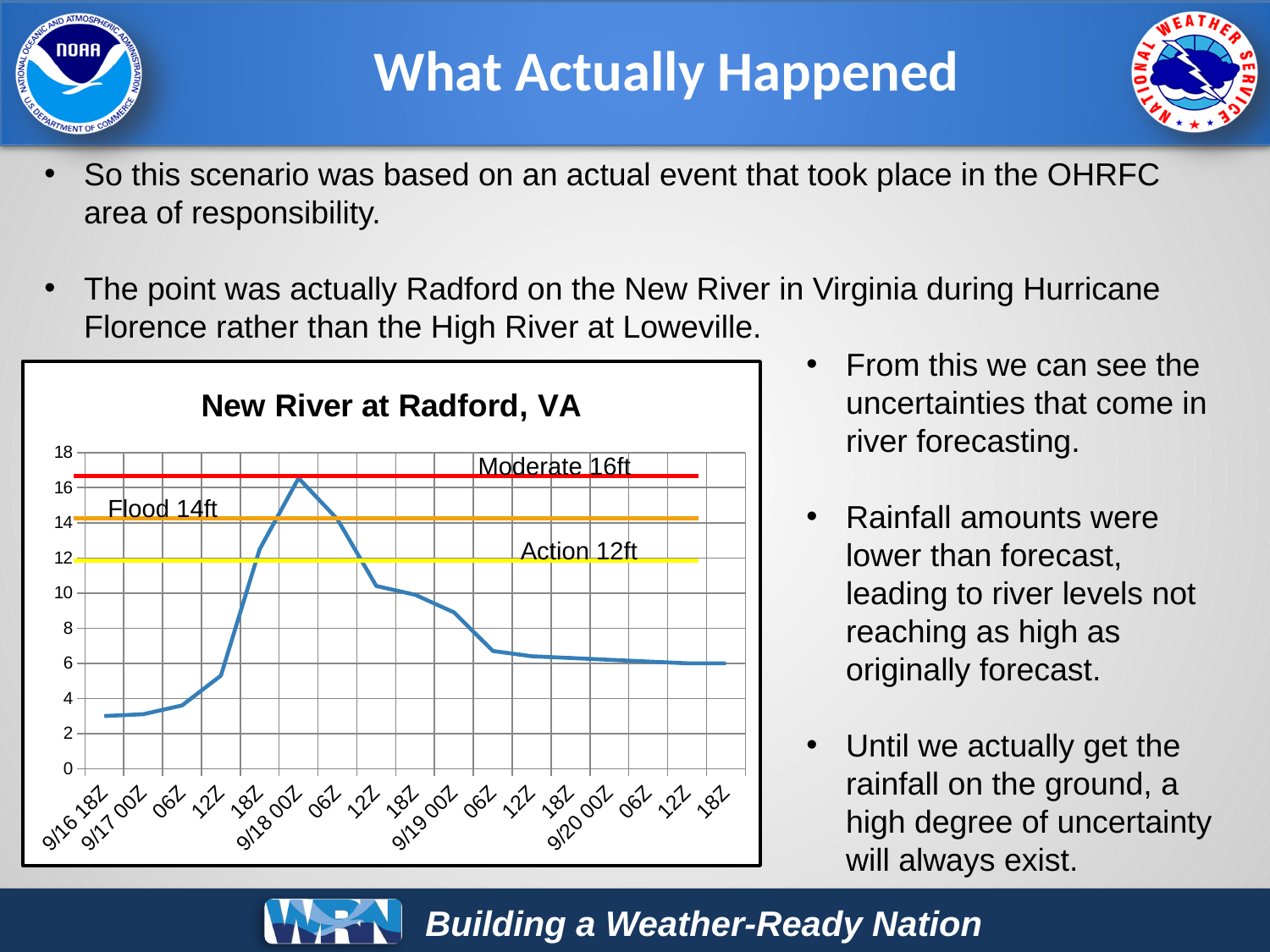
Is the river level at 9/18 12Z greater or less than 12? less How many time labels are shown along the x axis of the chart? 17 Is the river level at 9/18 00Z greater or less than 14? greater At which time does the river level reach its highest point? 9/18 00Z What type of chart is shown on the slide? line chart Does the river level rise or fall from 9/18 00Z to 9/20 18Z? fall Is the river level at 9/17 12Z greater or less than 6? less Which is higher, the river level at 9/17 18Z or at 9/18 06Z? 9/18 06Z What stage value is labeled on the red Moderate reference line? 16ft What is the title of the chart? New River at Radford, VA